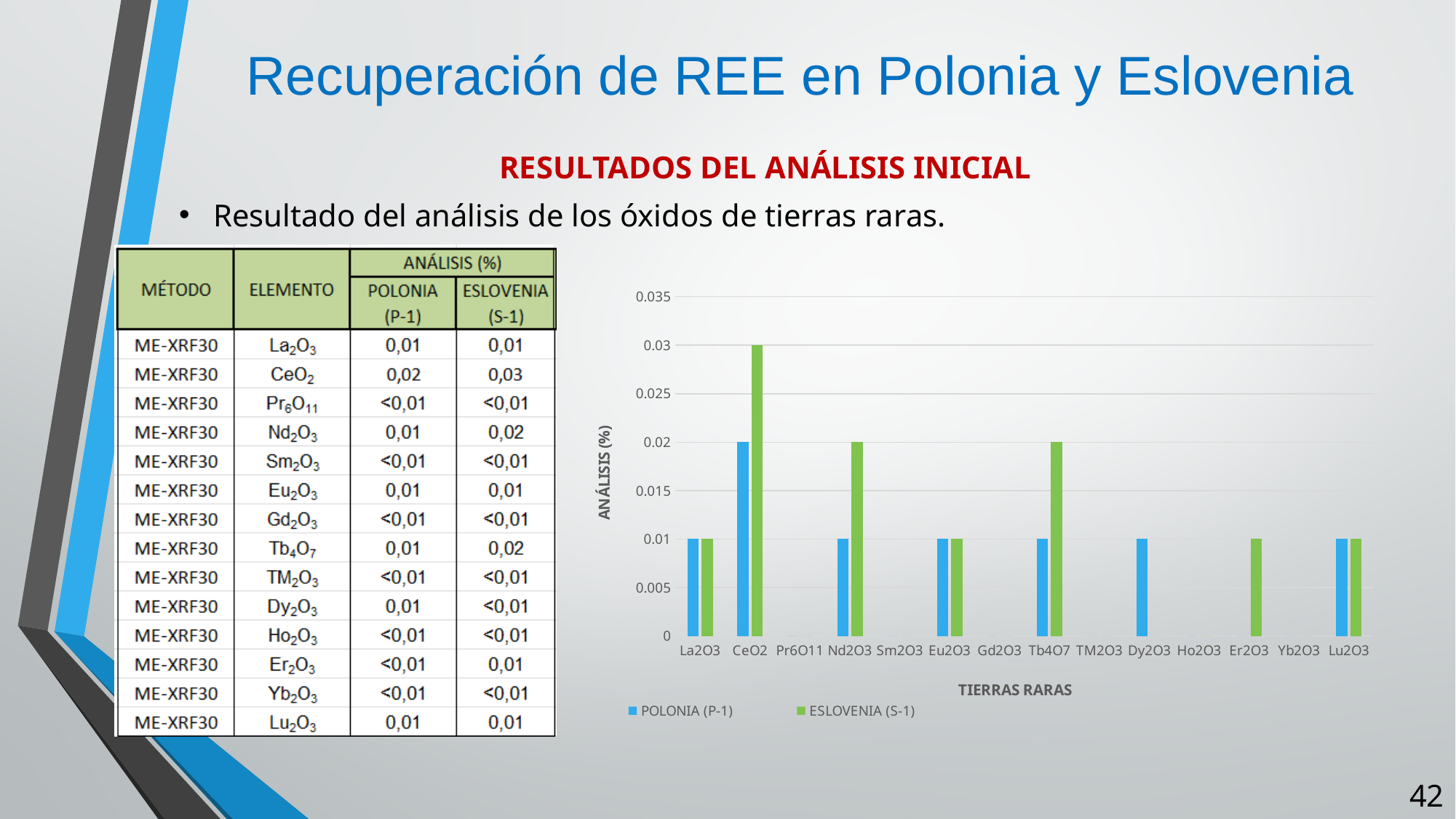
For Tb4O7, which series has the larger value, POLONIA (P-1) or ESLOVENIA (S-1)? ESLOVENIA (S-1) What kind of chart is shown on the slide? bar chart How many series does the chart legend list? 2 What is the title of the x axis of the chart? TIERRAS RARAS What is the ESLOVENIA (S-1) value for Nd2O3 in the chart? 0.02 What is the POLONIA (P-1) value for CeO2 in the chart? 0.02 Which category has the highest POLONIA (P-1) value in the chart? CeO2 Is the ESLOVENIA (S-1) value for CeO2 greater or less than 0.025? greater How many categories are shown on the x axis of the chart? 14 Which category has the highest ESLOVENIA (S-1) value in the chart? CeO2 What is the ESLOVENIA (S-1) value for CeO2 in the chart? 0.03 What is the difference between the ESLOVENIA (S-1) and POLONIA (P-1) values for CeO2? 0.01